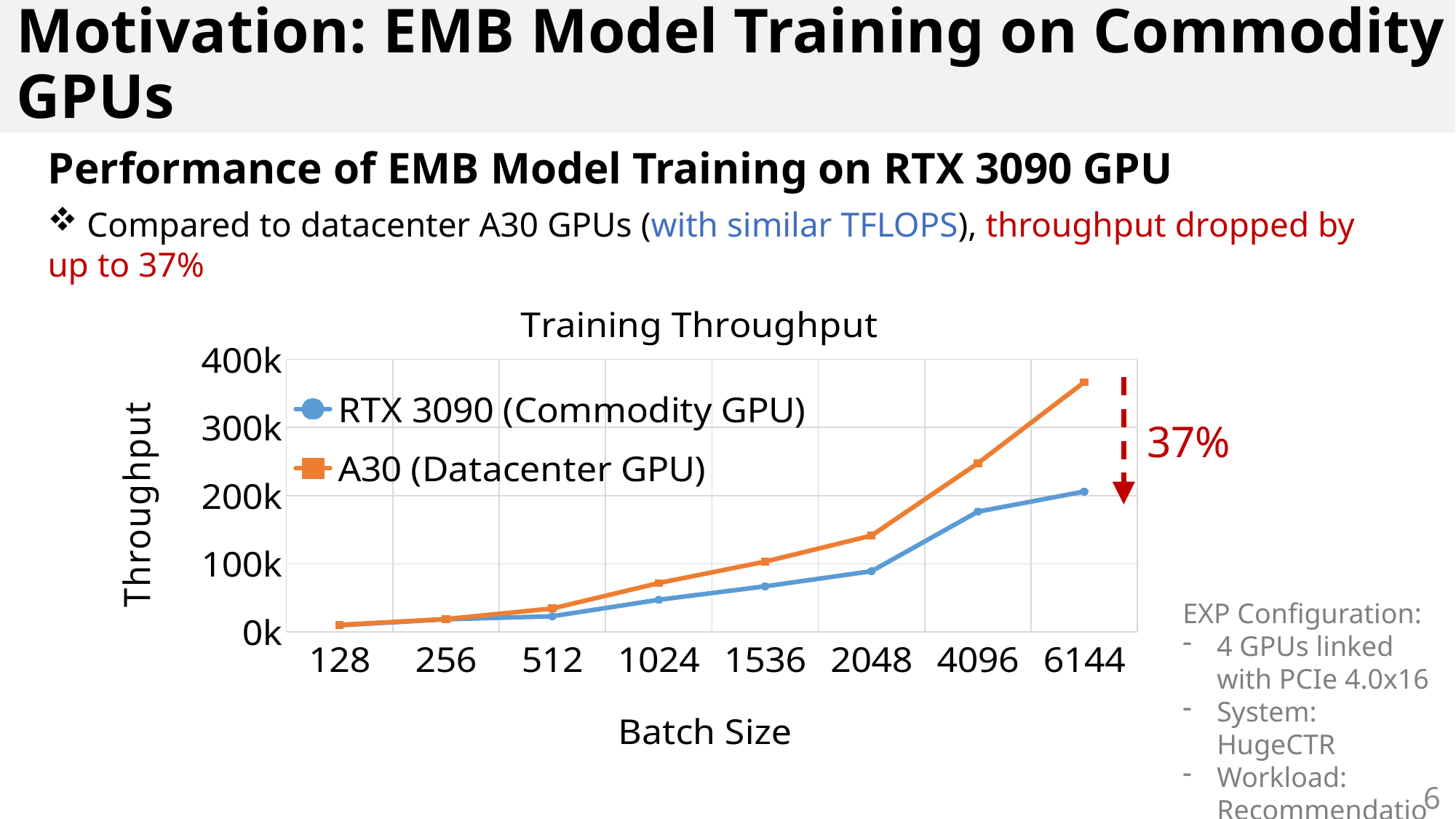
What kind of chart is shown on the slide? line chart Is the RTX 3090 (Commodity GPU) throughput at batch size 2048 greater or less than 100k? less What is the label of the x axis of the Training Throughput chart? Batch Size Is the A30 (Datacenter GPU) throughput at batch size 6144 greater or less than 300k? greater At batch size 6144, which series has the higher throughput, RTX 3090 (Commodity GPU) or A30 (Datacenter GPU)? A30 (Datacenter GPU) How many series does the legend of the Training Throughput chart list? 2 Is the A30 (Datacenter GPU) throughput at batch size 4096 greater or less than 200k? greater Does the RTX 3090 (Commodity GPU) throughput rise or fall as batch size increases? rise At which batch size does the A30 (Datacenter GPU) series reach its highest throughput? 6144 How many batch sizes are plotted along the x axis of the Training Throughput chart? 8